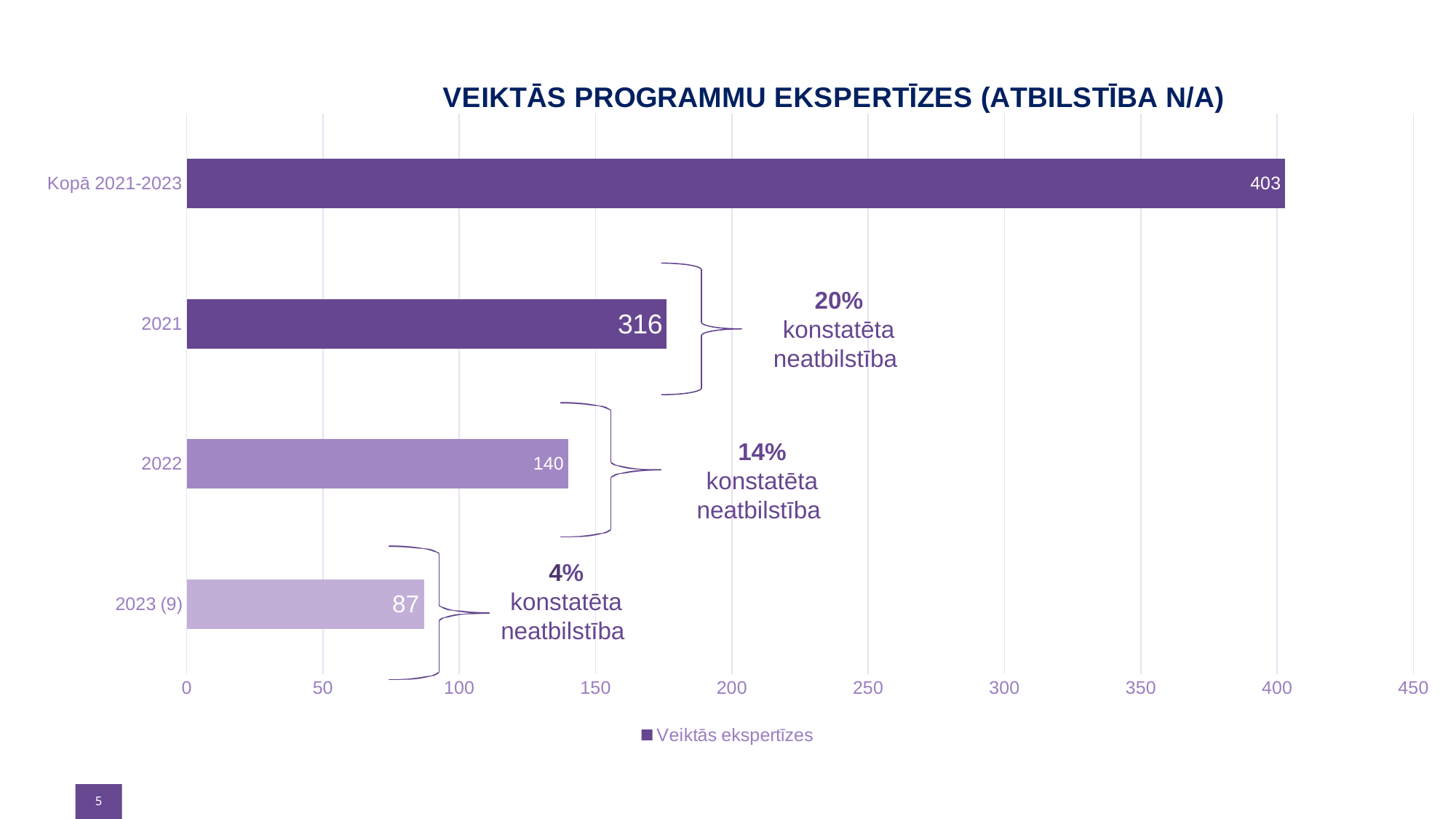
Is the value for 2023 (9) greater or less than 100? less How many categories are shown on the chart? 4 What series name does the legend show? Veiktās ekspertīzes What is the difference between the values for 2022 and 2023 (9)? 53 Which is larger, the value for 2022 or the value for 2023 (9)? 2022 Which category has the lowest value? 2023 (9) Which category has the highest value? Kopā 2021-2023 What is the value shown for 2022? 140 What is the value for Kopā 2021-2023? 403 What is the data label shown on the 2021 bar? 316 What is the value shown for 2023 (9)? 87 What type of chart is shown on the slide? bar chart